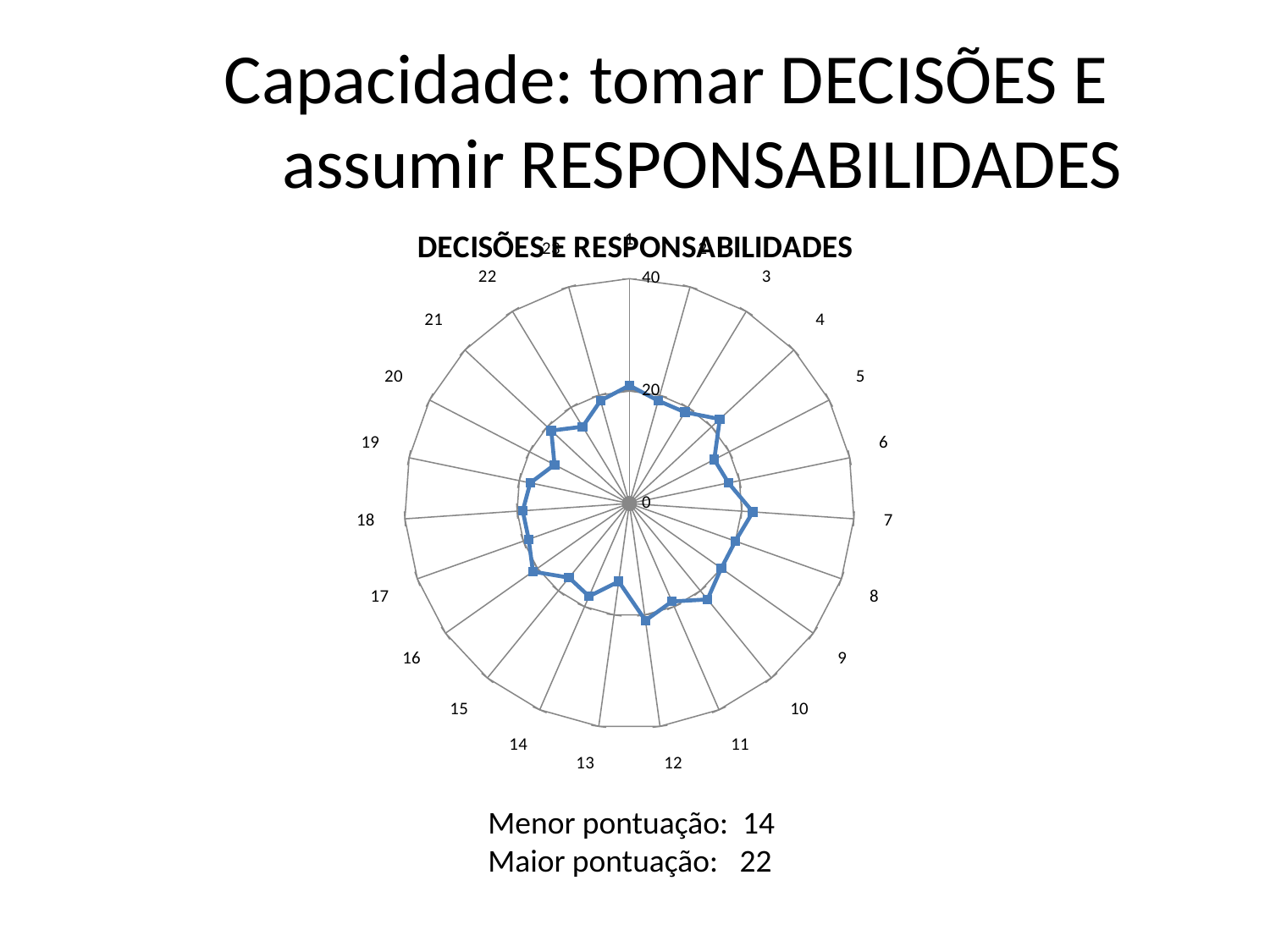
Is the value for category 14 greater or less than 20? less How many categories are plotted around the radar chart? 23 Which has the larger value, category 13 or category 1? 1 How many data series are plotted on the chart? 1 Is the value for category 5 greater or less than 20? less Which has the larger value, category 7 or category 13? 7 What is the title of the chart? DECISÕES E RESPONSABILIDADES Which category has the lowest value on the chart? 13 What is the highest value shown on the chart's radial axis? 40 Is the value for category 7 greater or less than 40? less What kind of chart is shown on the slide? Radar chart